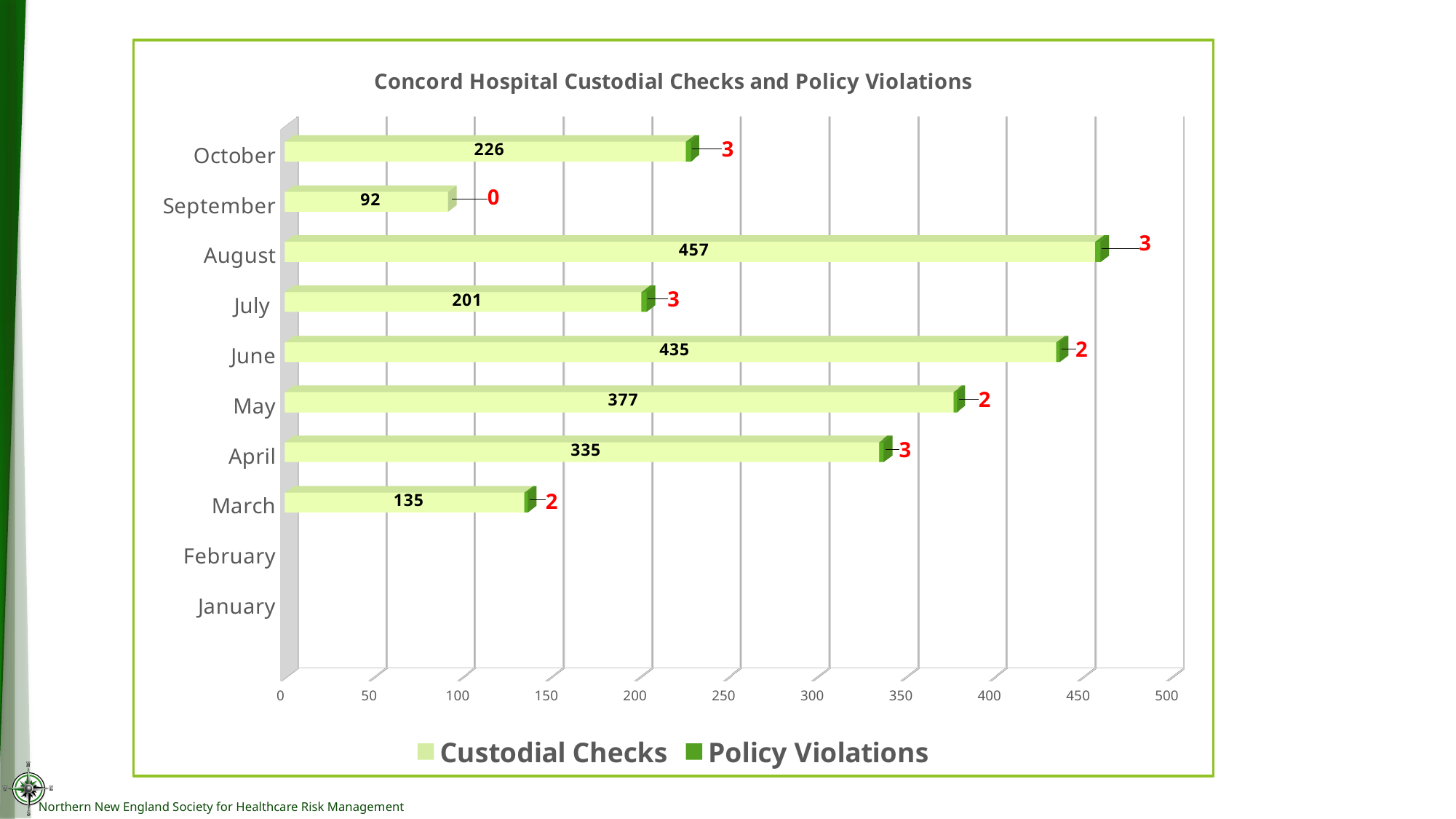
What is the Policy Violations value for September? 0 What is the Policy Violations value for July? 3 What is the total of the stacked bar for August (Custodial Checks plus Policy Violations)? 460 Is the Custodial Checks value for June greater or less than 400? greater How many series does the legend list? 2 What kind of chart is shown on the slide? bar chart How many months are listed on the vertical axis? 10 Which is larger, the Custodial Checks value for May or for April? May What is the difference between the Custodial Checks values for August and June? 22 Which month has the highest Custodial Checks value? August What is the Custodial Checks value for March? 135 Which month with a plotted bar has the lowest Custodial Checks value? September